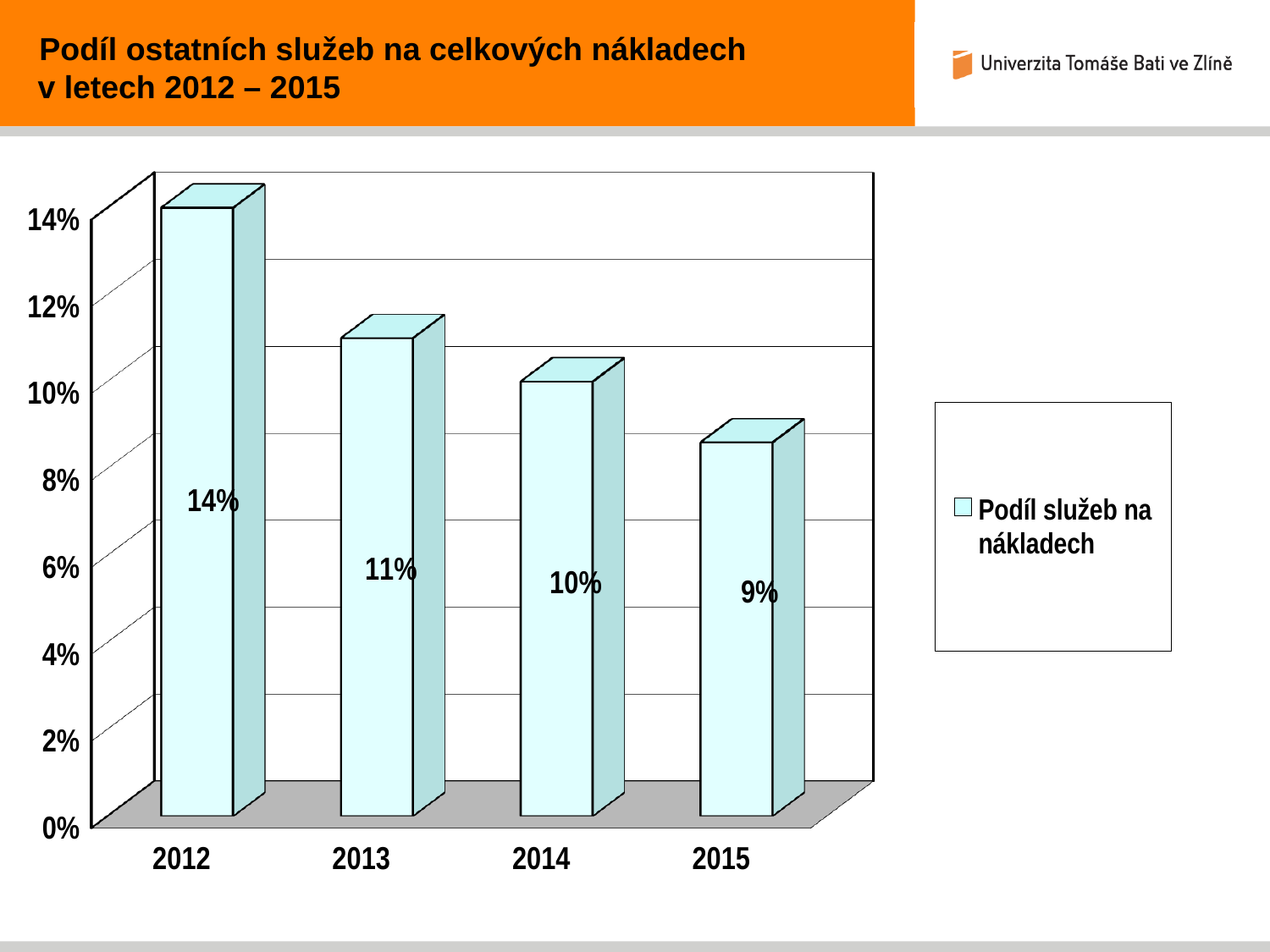
Which year has the lowest value? 2015 How many series does the legend list? 1 What kind of chart is shown? bar chart What is the value for 2014? 10% How many years are shown on the x axis? 4 What is the difference between the values for 2012 and 2015? 5% What is the value for 2012? 14% Which is larger, the value for 2013 or the value for 2014? 2013 What is the value for 2015? 9% Which year has the highest value? 2012 Do the values rise or fall from 2012 to 2015? fall What is the value for 2013? 11%